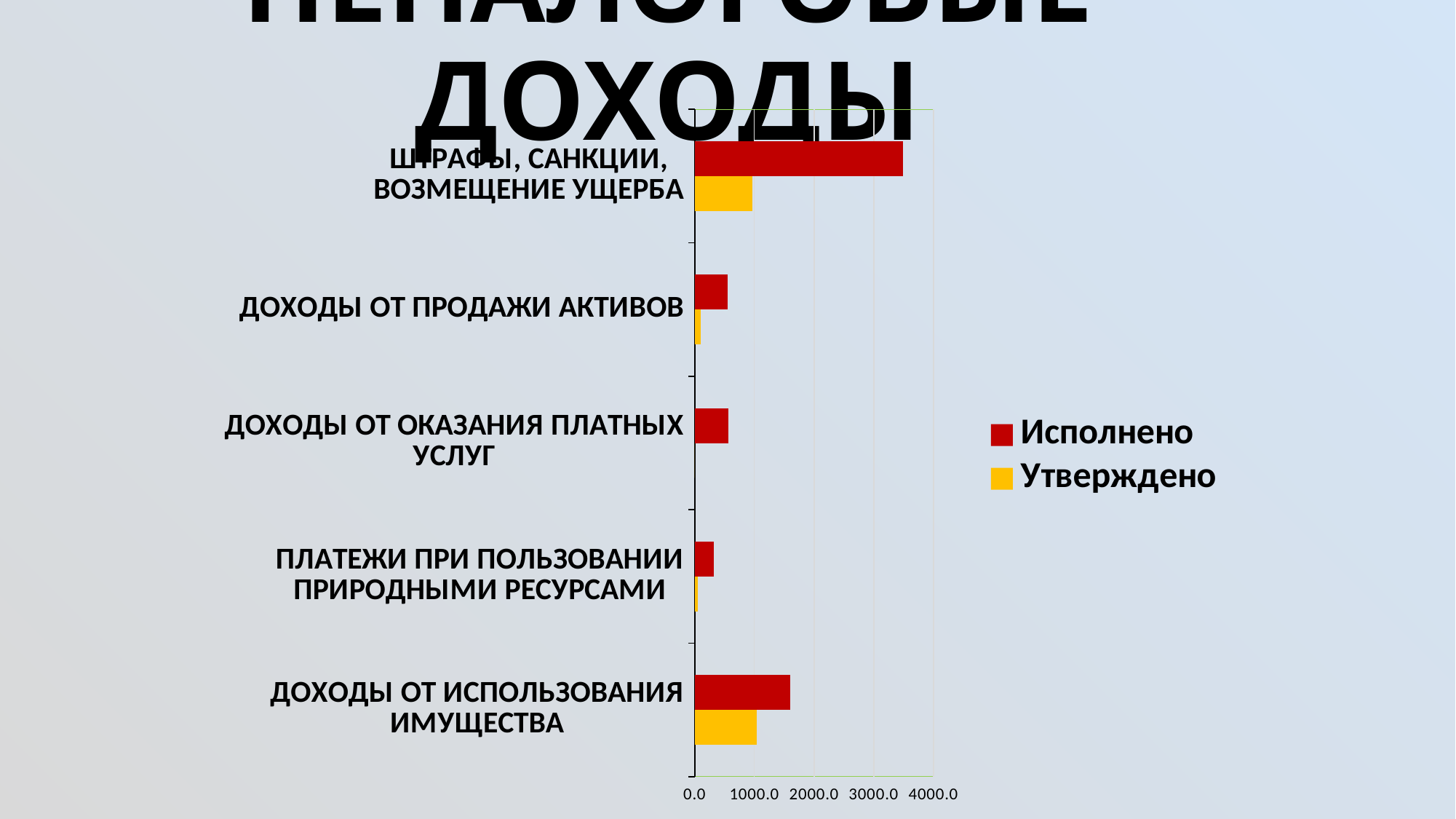
Which category has the larger Исполнено value: ДОХОДЫ ОТ ИСПОЛЬЗОВАНИЯ ИМУЩЕСТВА or ШТРАФЫ, САНКЦИИ, ВОЗМЕЩЕНИЕ УЩЕРБА? ШТРАФЫ, САНКЦИИ, ВОЗМЕЩЕНИЕ УЩЕРБА Is the Исполнено value for ШТРАФЫ, САНКЦИИ, ВОЗМЕЩЕНИЕ УЩЕРБА greater or less than 3000.0? greater What is the highest value shown on the horizontal axis? 4000.0 What kind of chart is shown on the slide? bar chart For ШТРАФЫ, САНКЦИИ, ВОЗМЕЩЕНИЕ УЩЕРБА, which is larger: Исполнено or Утверждено? Исполнено Which category has the lowest Исполнено value? ПЛАТЕЖИ ПРИ ПОЛЬЗОВАНИИ ПРИРОДНЫМИ РЕСУРСАМИ Is the Исполнено value for ДОХОДЫ ОТ ПРОДАЖИ АКТИВОВ greater or less than 1000.0? less How many series does the legend list? 2 How many categories are shown on the chart? 5 Which category has the highest Исполнено value? ШТРАФЫ, САНКЦИИ, ВОЗМЕЩЕНИЕ УЩЕРБА Is the Исполнено value for ДОХОДЫ ОТ ИСПОЛЬЗОВАНИЯ ИМУЩЕСТВА greater or less than 2000.0? less Which colour represents the Утверждено series? yellow